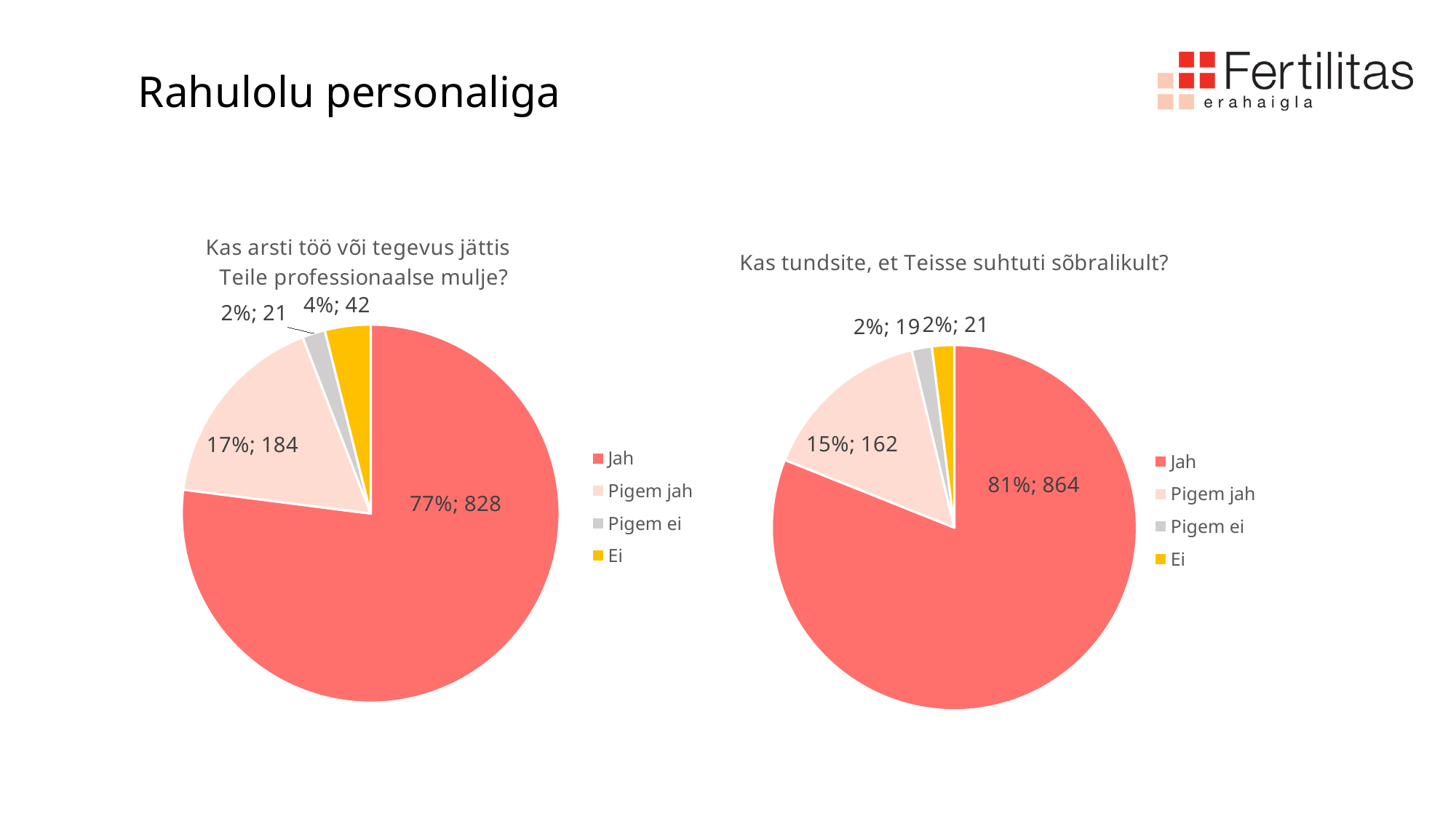
In the right pie chart (Kas tundsite, et Teisse suhtuti sõbralikult?), what is the count for Pigem jah? 162 In the left pie chart (Kas arsti töö või tegevus jättis Teile professionaalse mulje?), which category has the smallest slice? Pigem ei What type of chart is used for Kas tundsite, et Teisse suhtuti sõbralikult? Pie chart In the right pie chart (Kas tundsite, et Teisse suhtuti sõbralikult?), what share of the pie is Jah? 81% In the right pie chart (Kas tundsite, et Teisse suhtuti sõbralikult?), what is the count for Pigem ei? 19 In the left pie chart (Kas arsti töö või tegevus jättis Teile professionaalse mulje?), what share of the pie is Pigem jah? 17% In the left pie chart (Kas arsti töö või tegevus jättis Teile professionaalse mulje?), what is the difference between the counts for Jah and Pigem jah? 644 In the left pie chart (Kas arsti töö või tegevus jättis Teile professionaalse mulje?), what is the count for Ei? 42 In the right pie chart (Kas tundsite, et Teisse suhtuti sõbralikult?), which category has the largest slice? Jah Which chart has the larger count for Jah: the left pie chart or the right pie chart? The right pie chart How many categories does the legend of the left pie chart list? 4 In the left pie chart (Kas arsti töö või tegevus jättis Teile professionaalse mulje?), what is the count for Jah? 828